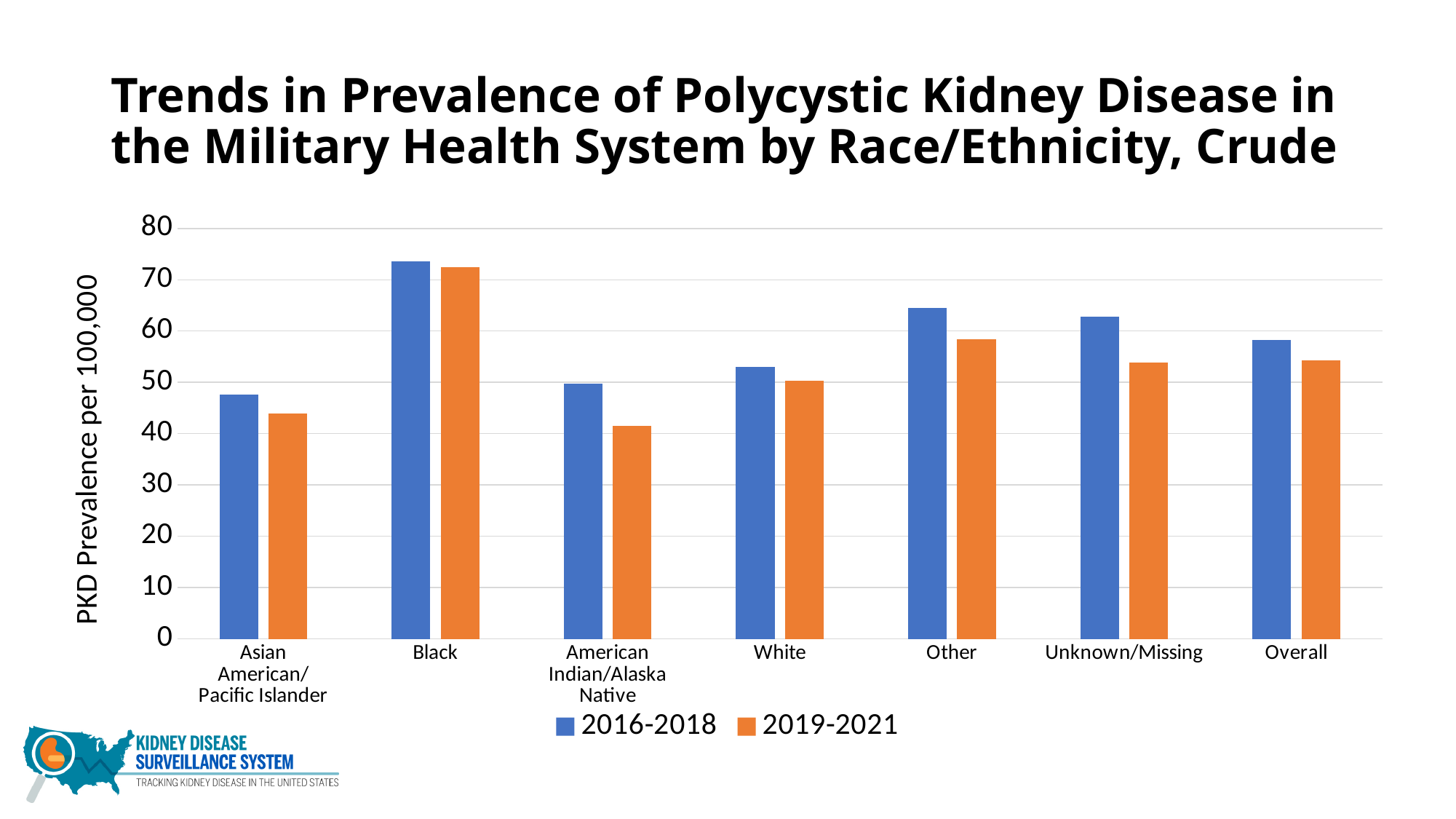
Which category has the highest PKD prevalence for 2019-2021? Black How many series does the legend list? 2 What kind of chart is shown on the slide? Bar chart What is the label of the y axis? PKD Prevalence per 100,000 How many race/ethnicity categories are shown on the x axis? 7 Is the 2016-2018 value for Asian American/Pacific Islander greater or less than 50? less Is the 2016-2018 value for Black greater or less than 70? greater Which is larger for 2016-2018: the value for White or the value for Overall? Overall Is the 2016-2018 value for Other greater or less than 60? greater Which category has the highest PKD prevalence for 2016-2018? Black Which category has the lowest PKD prevalence for 2019-2021? American Indian/Alaska Native